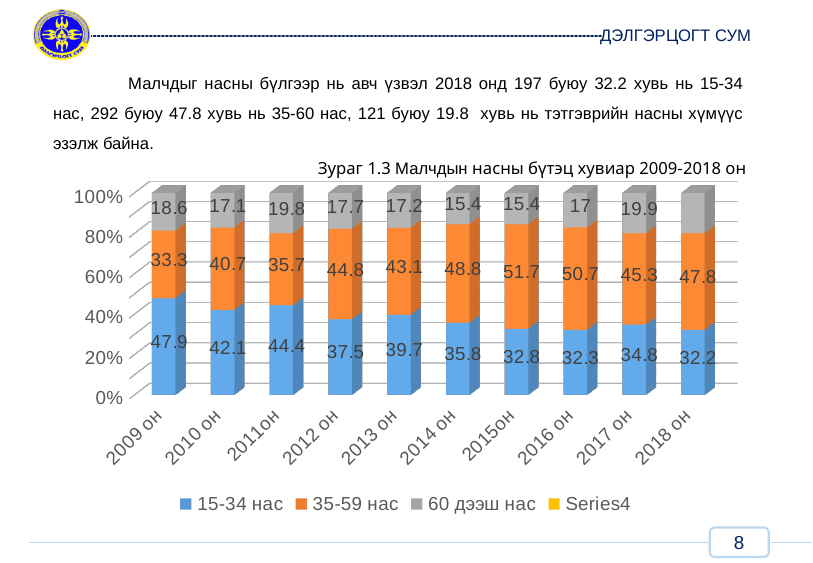
What is the value for 35-59 нас in 2018 он? 47.8 Does the 15-34 нас value rise or fall overall from 2009 он to 2018 он? Falls How many series does the legend list? 4 What is the value for 15-34 нас in 2009 он? 47.9 What kind of chart is shown? Stacked bar chart In which year is the 15-34 нас value highest? 2009 он In 2014 он, which is larger: the 15-34 нас value or the 35-59 нас value? 35-59 нас What is the value for 60 дээш нас in 2011он? 19.8 In which year is the 35-59 нас value lowest? 2009 он What is the difference between the 15-34 нас values for 2009 он and 2018 он? 15.7 How many years are shown on the x axis? 10 What is the value for 35-59 нас in 2015он? 51.7